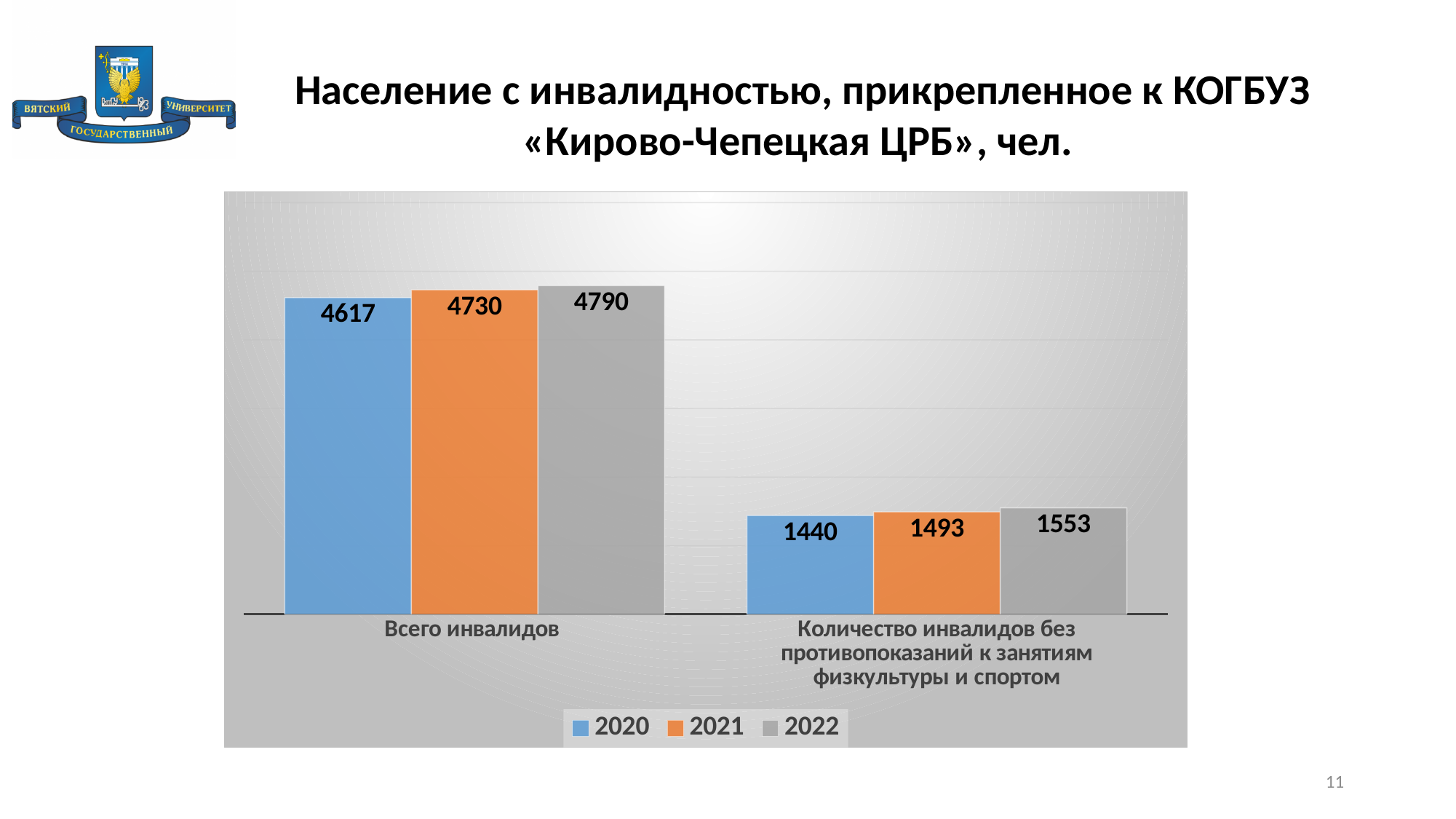
What is the value for 2020 in the 'Всего инвалидов' category? 4617 Which is larger: the 2021 value for 'Всего инвалидов' or the 2022 value for 'Всего инвалидов'? 2022 value for 'Всего инвалидов' Which year has the highest value in the 'Всего инвалидов' category? 2022 Do the values for 'Всего инвалидов' rise or fall from 2020 to 2022? Rise What kind of chart is shown on the slide? Bar chart Which year has the lowest value in the 'Количество инвалидов без противопоказаний к занятиям физкультуры и спортом' category? 2020 How many categories are shown on the x axis? 2 What is the value for 2021 in the 'Всего инвалидов' category? 4730 What is the difference between the 2022 and 2020 values in the 'Всего инвалидов' category? 173 What is the difference between the 2021 and 2020 values in the 'Количество инвалидов без противопоказаний к занятиям физкультуры и спортом' category? 53 What is the value for 2022 in the 'Количество инвалидов без противопоказаний к занятиям физкультуры и спортом' category? 1553 How many series does the legend list? 3